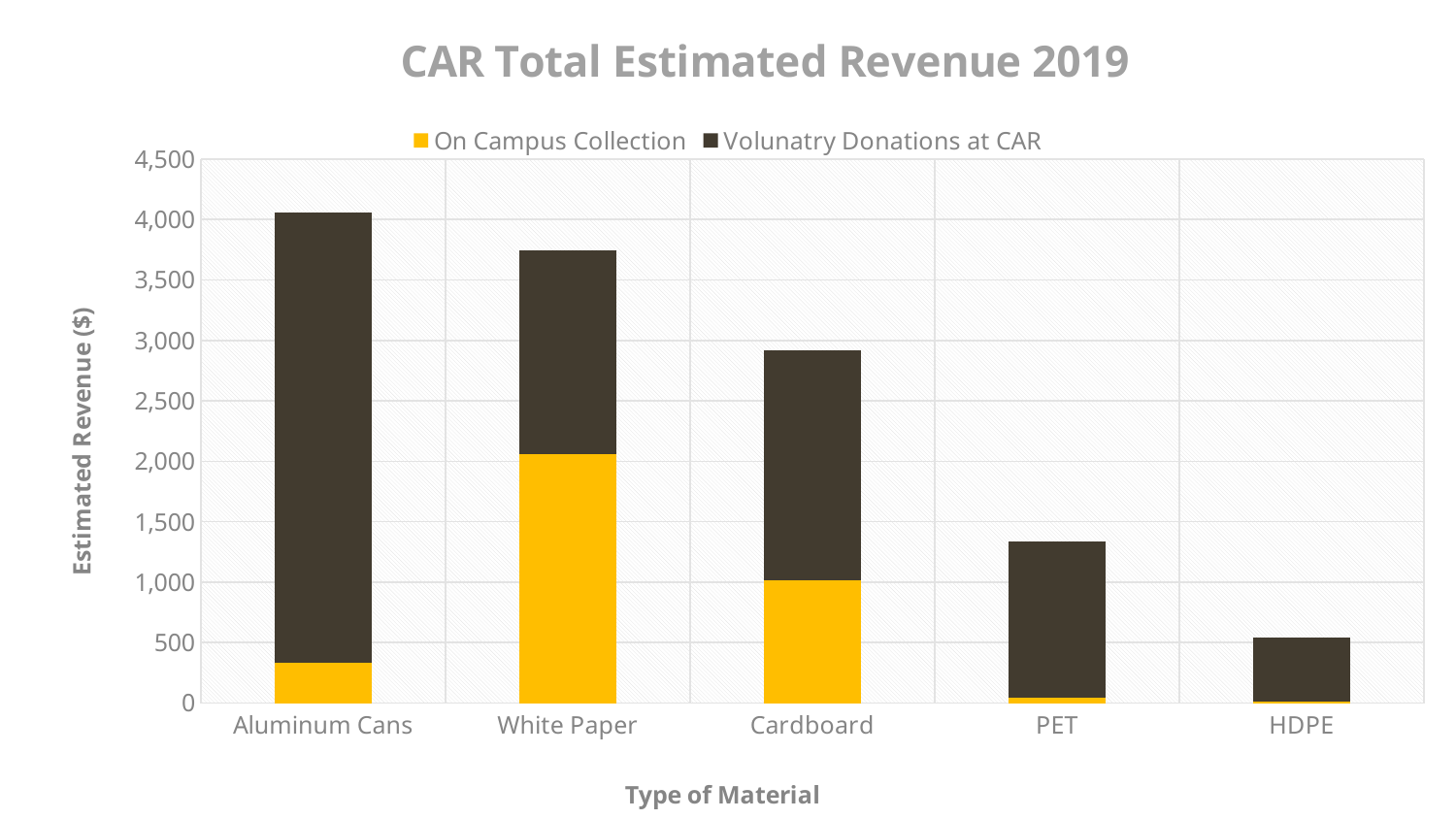
Which type of material has the lowest total estimated revenue? HDPE Do the total estimated revenues rise or fall moving from Aluminum Cans to HDPE along the x axis? fall How many types of material are shown on the x axis? 5 Is the total estimated revenue for PET greater or less than 1,000? greater What is the title of the chart? CAR Total Estimated Revenue 2019 Is the total estimated revenue for HDPE greater or less than 1,000? less What kind of chart is shown on the slide? Stacked bar chart Which material has the largest On Campus Collection revenue? White Paper Which has a larger total estimated revenue, White Paper or Cardboard? White Paper Is the total estimated revenue for Aluminum Cans greater or less than 3,500? greater How many series does the legend list? 2 Which type of material has the highest total estimated revenue? Aluminum Cans